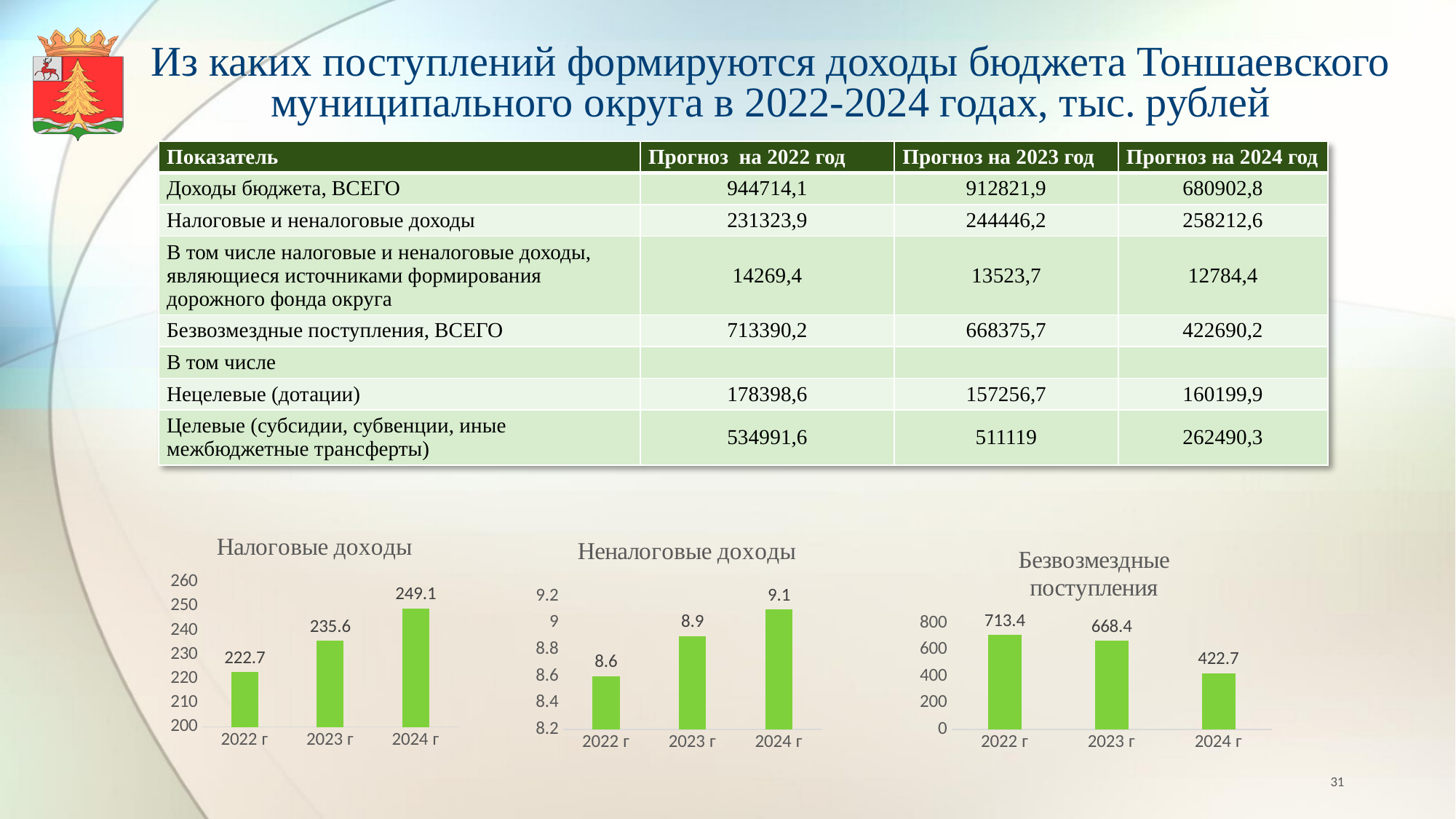
What type of chart is the 'Безвозмездные поступления' chart? bar chart In the 'Налоговые доходы' chart, what is the difference between the values for 2024 г and 2022 г? 26.4 In the 'Безвозмездные поступления' chart, do the values rise or fall from 2022 г to 2024 г? fall In the 'Безвозмездные поступления' chart, what is the value for 2024 г? 422.7 In the 'Безвозмездные поступления' chart, what is the difference between the values for 2022 г and 2024 г? 290.7 In the 'Неналоговые доходы' chart, how many bars are plotted? 3 In the 'Налоговые доходы' chart, what is the value for 2022 г? 222.7 In the 'Неналоговые доходы' chart, which year has the lowest value? 2022 г In the 'Безвозмездные поступления' chart, which is larger, the value for 2022 г or 2023 г? 2022 г In the 'Налоговые доходы' chart, which year has the highest value? 2024 г In the 'Налоговые доходы' chart, do the values rise or fall from 2022 г to 2024 г? rise In the 'Неналоговые доходы' chart, what is the value for 2023 г? 8.9